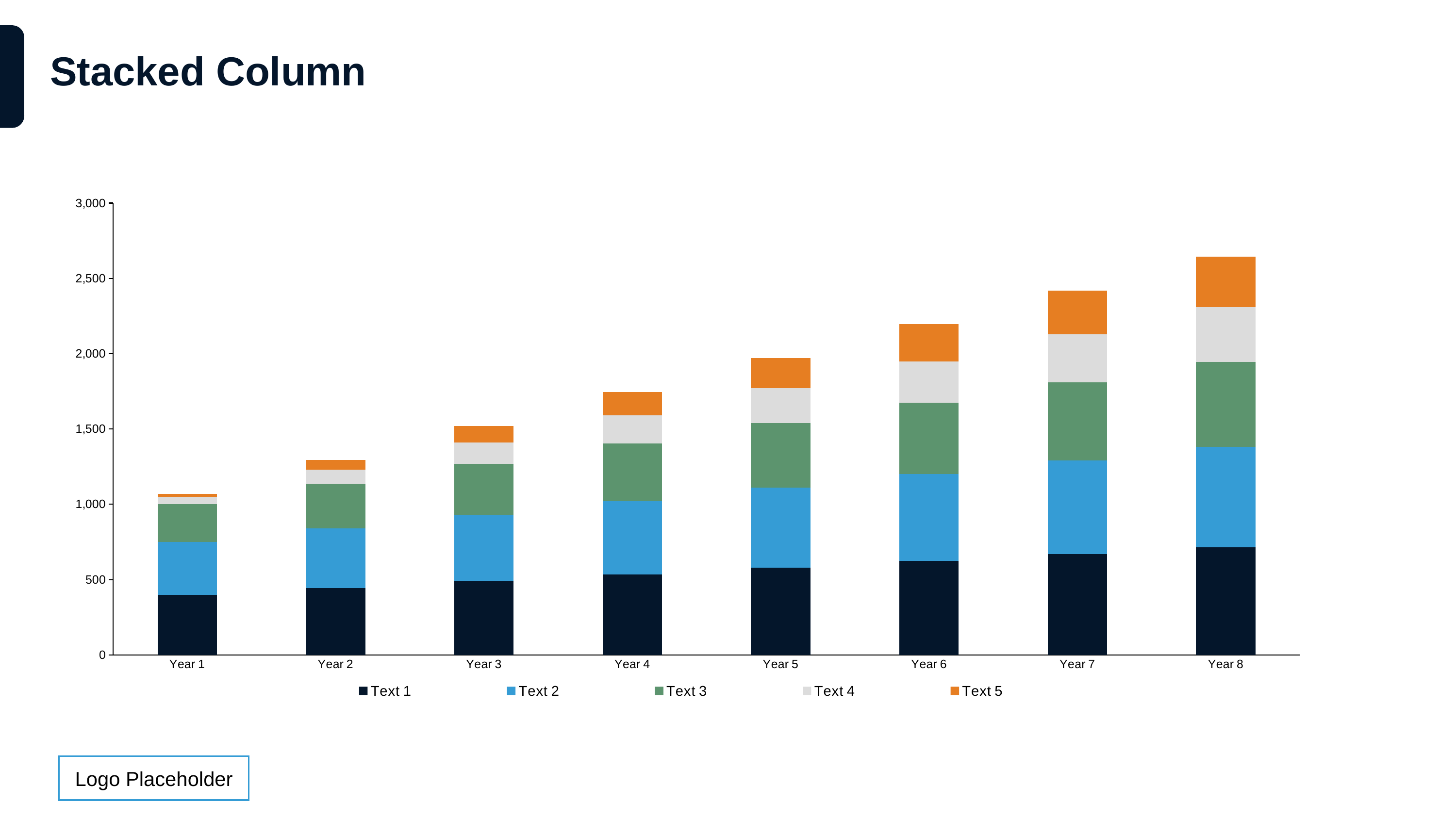
Which year has the lowest total stacked bar? Year 1 Do the total bar heights rise or fall from Year 1 to Year 8? Rise How many categories are shown on the x axis? 8 Which is larger, the total for Year 2 or the total for Year 7? Year 7 Is the total for Year 4 greater or less than 2,000? less Is the total for Year 8 greater or less than 2,500? greater How many series does the legend list? 5 Which year has the highest total stacked bar? Year 8 What is the title of the slide? Stacked Column Is the Text 1 value for Year 1 greater or less than 500? less What kind of chart is shown on the slide? Stacked bar chart